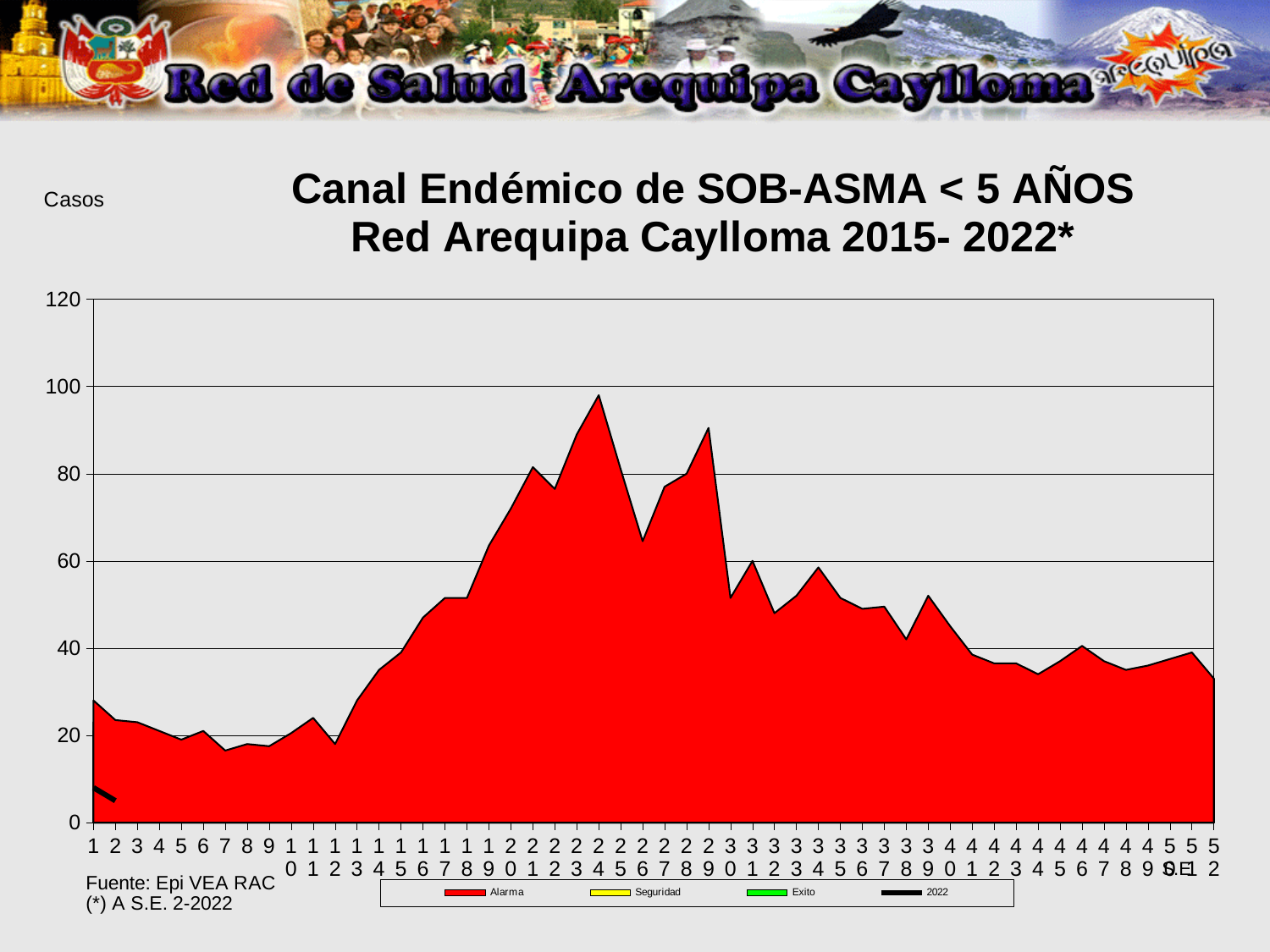
Which week has a larger Alarma value, week 10 or week 20? week 20 What kind of chart is shown on the slide? area chart What is the title of the chart? Canal Endémico de SOB-ASMA < 5 AÑOS Red Arequipa Caylloma 2015- 2022* At which week does the Alarma area reach its highest value? 24 Is the Alarma value at week 29 greater or less than 80? greater Do the Alarma values rise or fall from week 13 to week 24? rise Is the Alarma value at week 52 greater or less than 40? less What are the series names listed in the legend? Alarma, Seguridad, Exito, 2022 How many epidemiological weeks are shown along the x axis? 52 How many series does the legend list? 4 Is the Alarma value at week 1 greater or less than 40? less